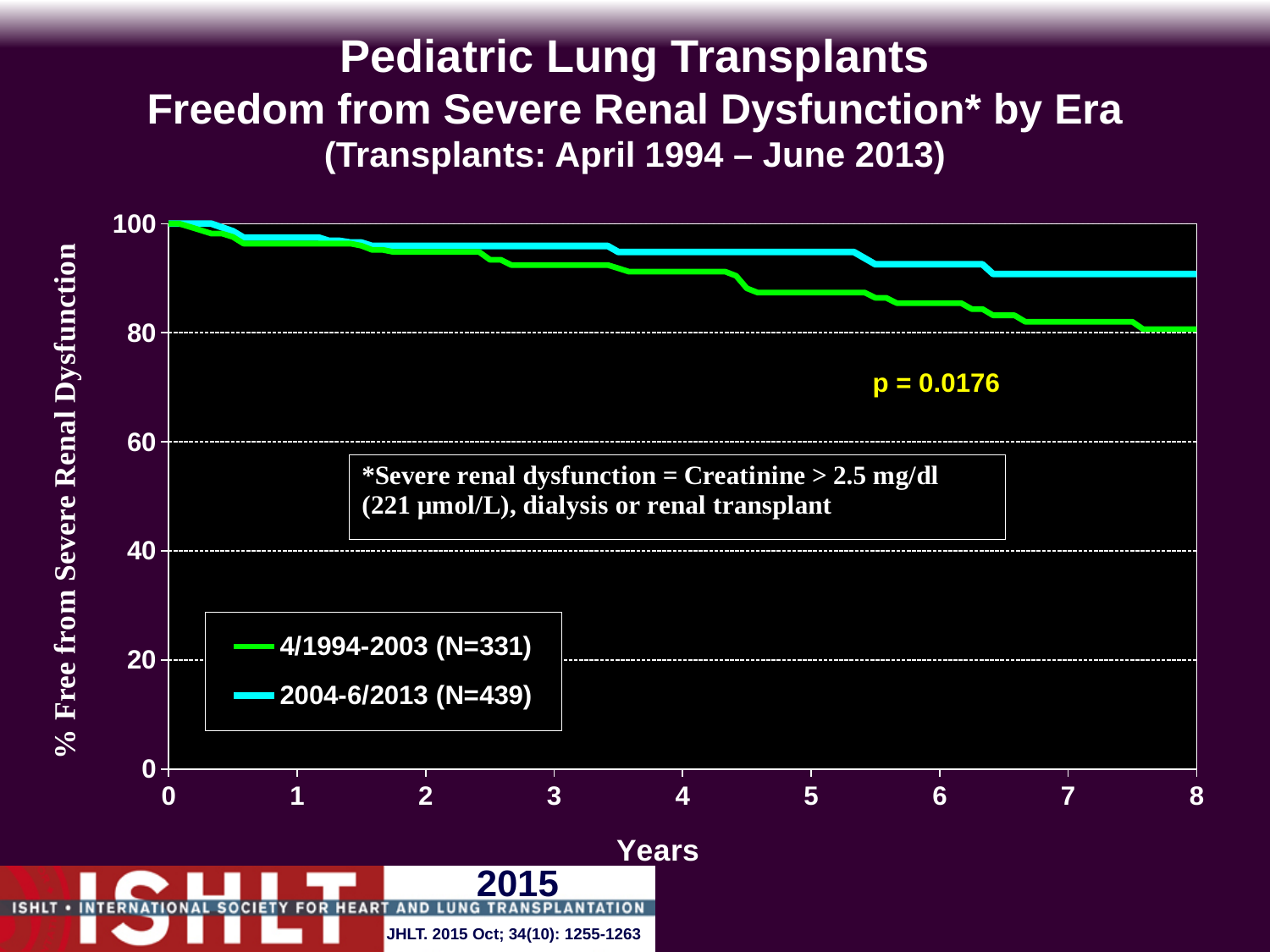
What p-value is printed on the chart? p = 0.0176 Is the value for the 2004-6/2013 series at 8 years greater or less than 80? greater What is the label of the x axis? Years How many series does the legend list? 2 Which series has the higher % free from severe renal dysfunction at 8 years? 2004-6/2013 (N=439) What is the N for the 2004-6/2013 series in the legend? 439 What is the N for the 4/1994-2003 series in the legend? 331 Is the value for the 2004-6/2013 series at 4 years greater or less than 80? greater Which series has the lower % free from severe renal dysfunction at 6 years? 4/1994-2003 (N=331) What kind of chart is shown on the slide? line chart Is the value for the 4/1994-2003 series at 6 years greater or less than 80? greater Do the values for the 4/1994-2003 series rise or fall as years increase? fall